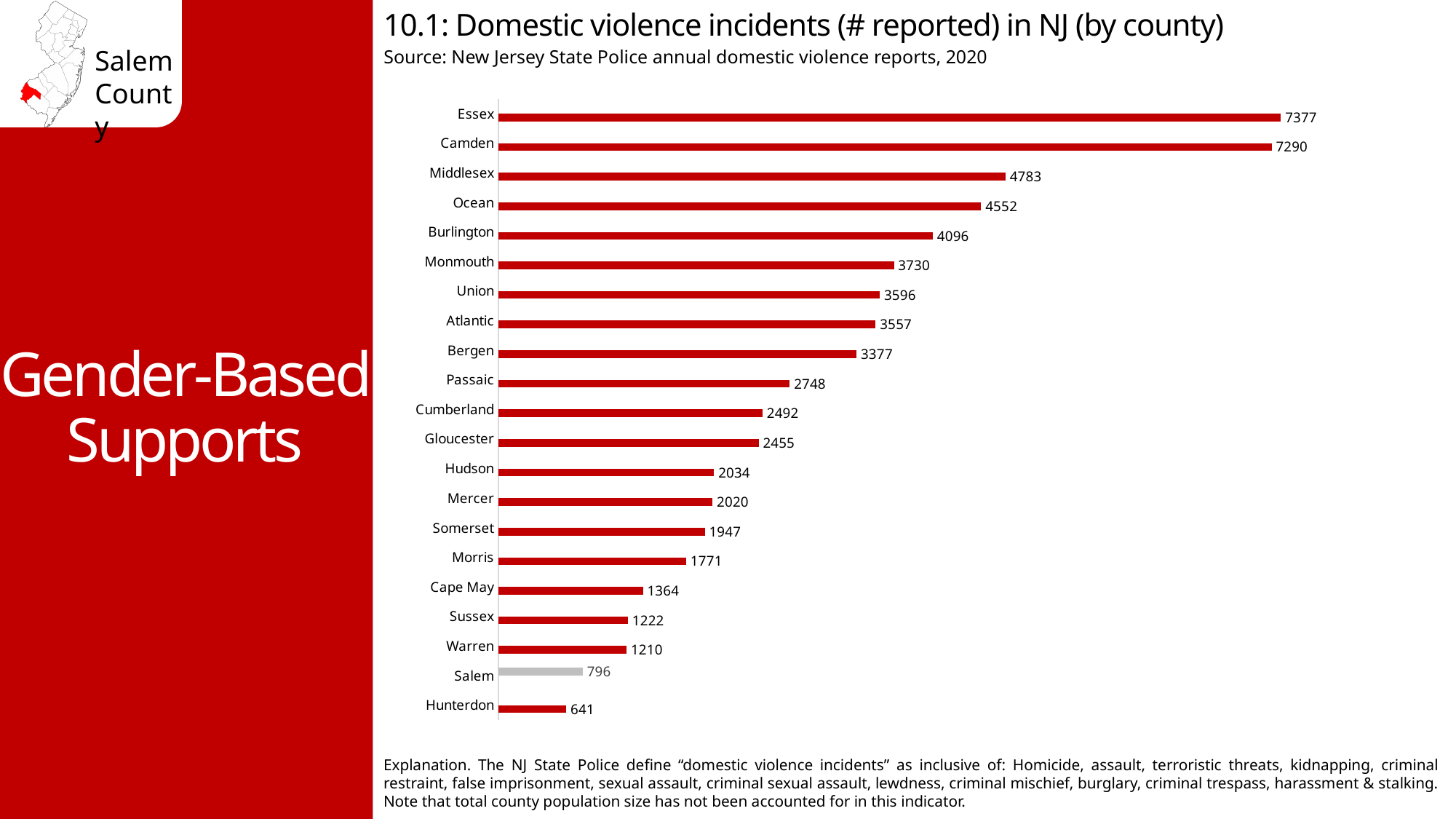
Which county has the lowest number of reported domestic violence incidents? Hunterdon What is the difference between the reported incidents in Salem and Hunterdon? 155 Which county has more reported incidents, Middlesex or Ocean? Middlesex Which county's bar is shown in grey rather than red? Salem What type of chart is used to show domestic violence incidents by county? Bar chart How many counties are shown in the chart? 21 What is the number of reported domestic violence incidents for Camden? 7290 What is the value shown for Gloucester? 2455 Which county has more reported incidents, Sussex or Warren? Sussex What is the difference between the reported incidents in Essex and Camden? 87 How many domestic violence incidents were reported in Salem County? 796 Which county has the highest number of reported domestic violence incidents? Essex